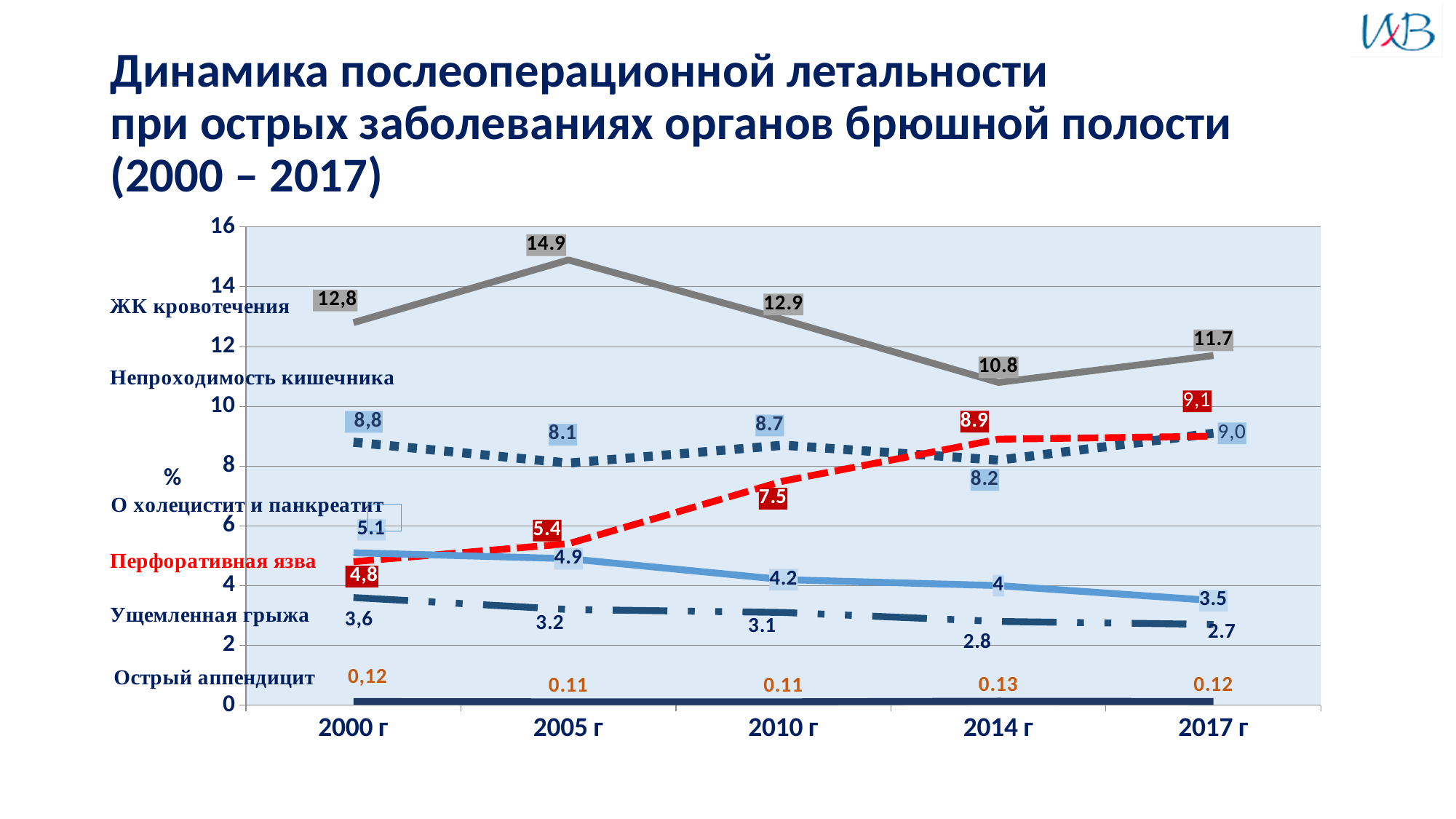
What is the value for Ущемленная грыжа in 2014 г? 2.8 Which is larger in 2010 г: Непроходимость кишечника or Перфоративная язва? Непроходимость кишечника In which year is the value for ЖК кровотечения the highest? 2005 г What is the difference between the ЖК кровотечения values in 2005 г and 2014 г? 4.1 What type of chart is shown on the slide? line chart How many years are shown on the x axis? 5 In which year is the value for О холецистит и панкреатит the lowest? 2017 г How many series are labelled on the chart? 6 Does the value for Перфоративная язва rise or fall from 2000 г to 2017 г? rise What is the value for ЖК кровотечения in 2005 г? 14.9 What is the value for Острый аппендицит in 2000 г? 0,12 What is the value for Перфоративная язва in 2017 г? 9,1